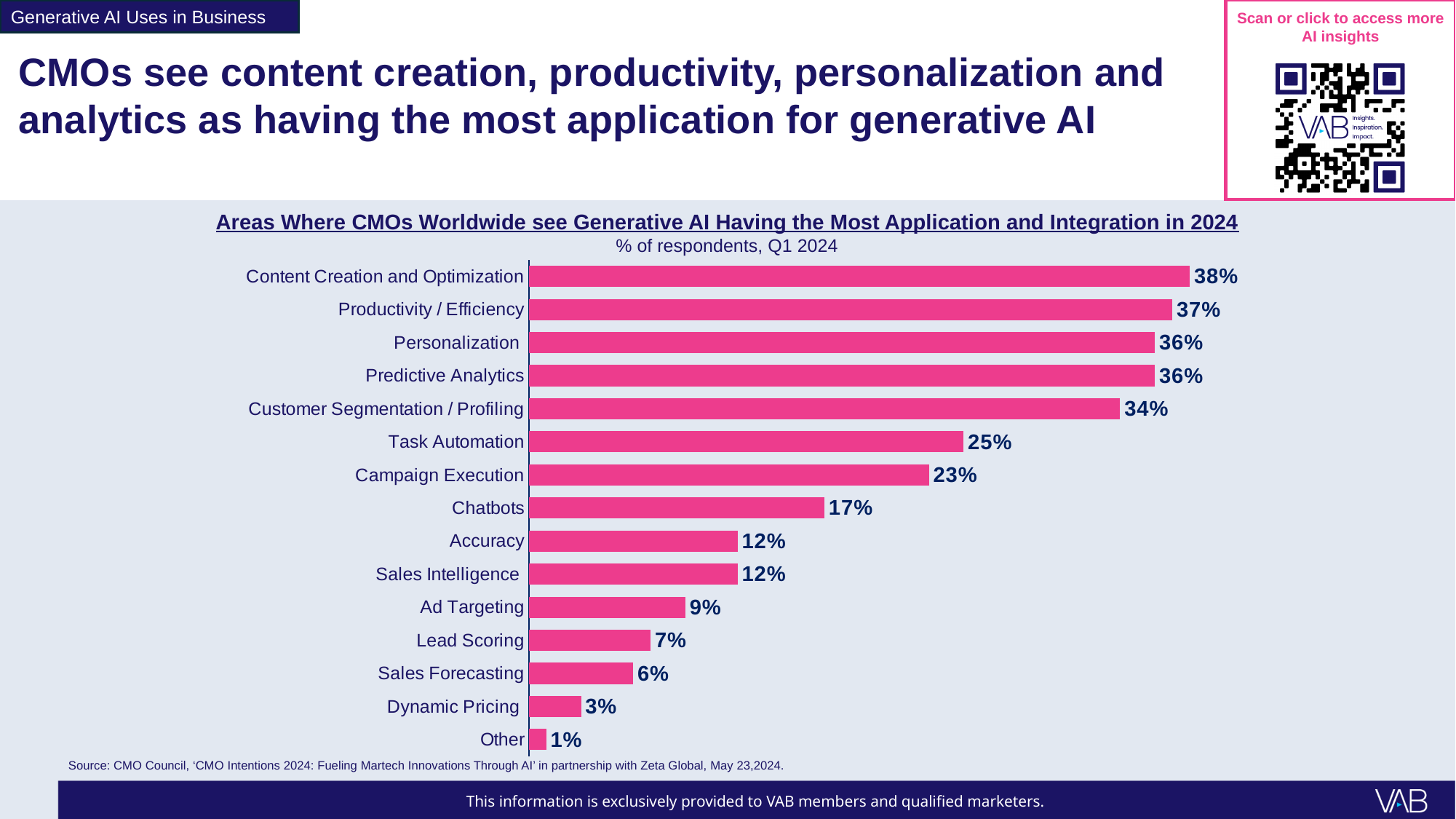
What kind of chart is shown on the slide? Bar chart Which is larger, the value for Campaign Execution or the value for Ad Targeting? Campaign Execution What colour are the bars on the chart? Pink What is the title of the chart? Areas Where CMOs Worldwide see Generative AI Having the Most Application and Integration in 2024 What is the value shown for Chatbots? 17% How many categories are shown on the chart? 15 What is the difference between the values for Customer Segmentation / Profiling and Sales Forecasting? 28% What percentage of respondents selected Content Creation and Optimization? 38% What is the difference between the values for Productivity / Efficiency and Task Automation? 12% What percentage is shown for Dynamic Pricing? 3% Which category has the highest value on the chart? Content Creation and Optimization Which category has the lowest value on the chart? Other